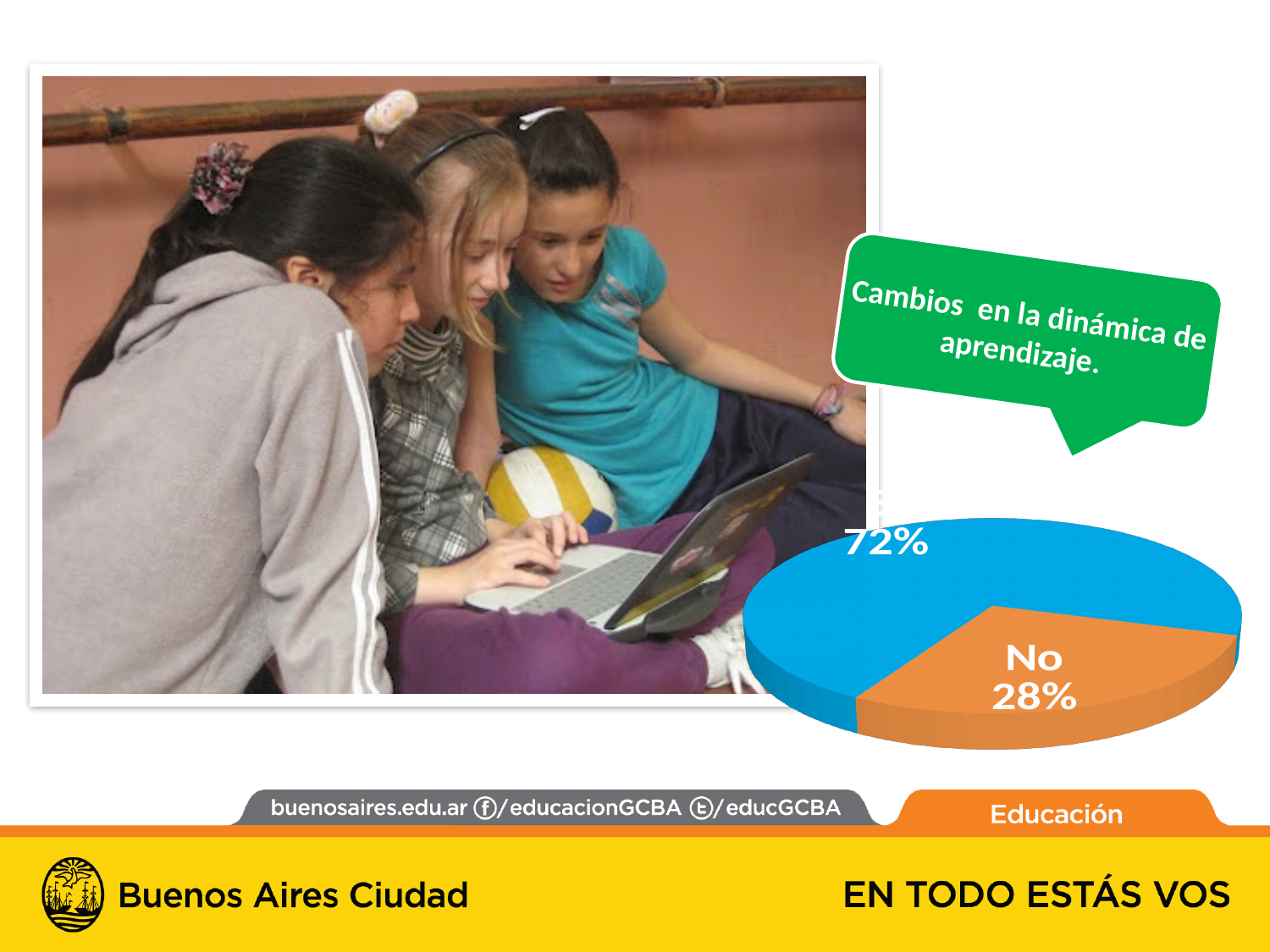
What percentage is shown for the blue slice of the pie chart? 72% Which slice of the pie chart is the smallest? No What text appears in the green speech bubble above the pie chart? Cambios en la dinámica de aprendizaje. What do the two slices of the pie chart add up to? 100% What percentage is shown for the "No" slice of the pie chart? 28% What kind of chart is shown on the slide? pie chart What share of the pie does the "No" slice represent? 28% Which slice of the pie chart is larger, the blue slice or the "No" slice? the blue slice How many slices does the pie chart have? 2 What is the difference in percentage points between the blue slice (72%) and the "No" slice (28%)? 44 percentage points What colour is the "No" slice of the pie chart? orange Is the value for the "No" slice greater or less than 50%? less